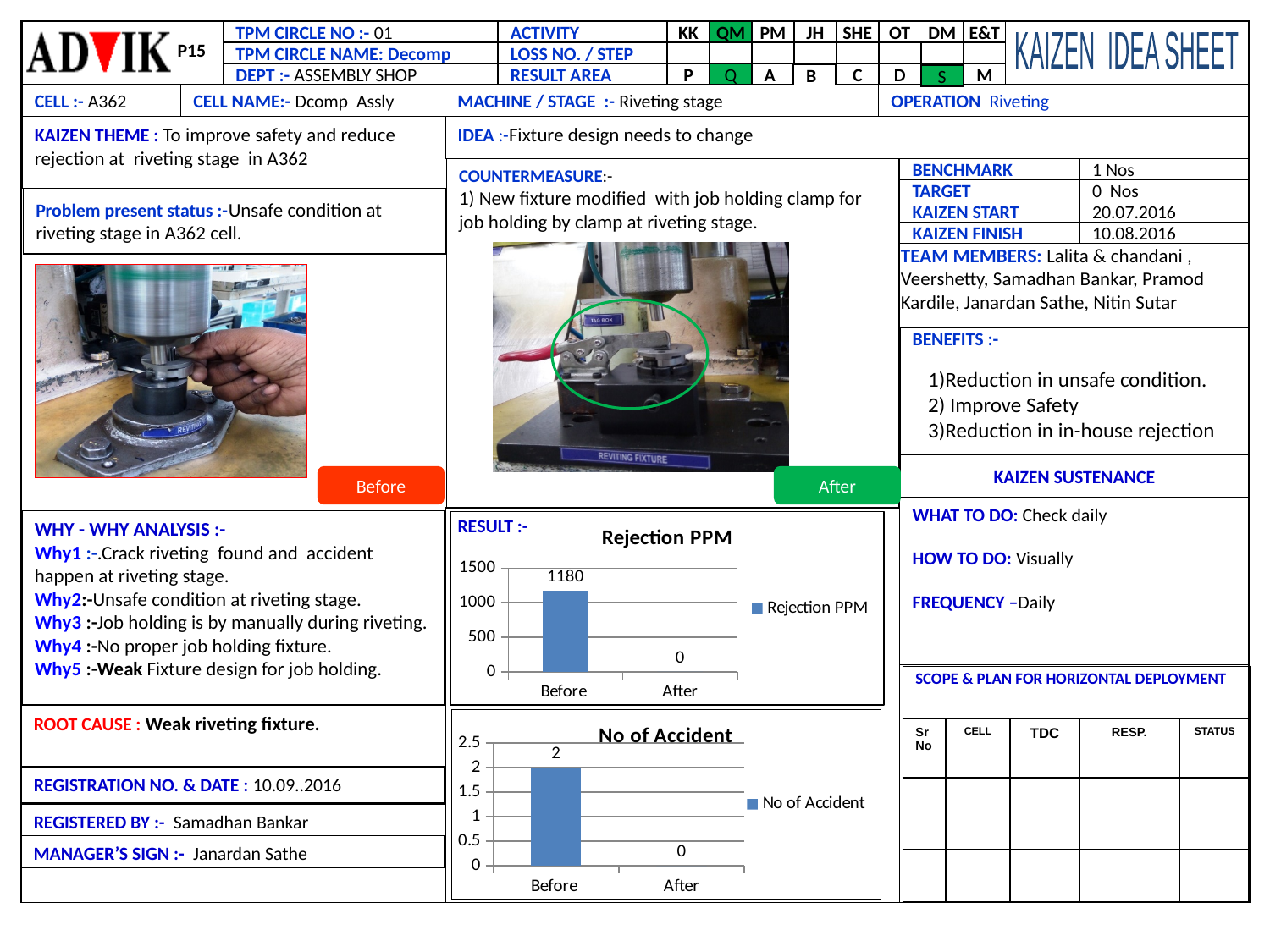
What type of chart is the Rejection PPM chart? Bar chart In the Rejection PPM chart, which category has the higher value, Before or After? Before In the No of Accident chart, how many categories are shown on the x axis? 2 In the No of Accident chart, do the values rise or fall from Before to After? Fall How many series does the legend of the Rejection PPM chart list? 1 In the No of Accident chart, what is the value for Before? 2 In the Rejection PPM chart, what is the value for Before? 1180 In the No of Accident chart, which category has the lowest value? After In the Rejection PPM chart, what is the value for After? 0 In the Rejection PPM chart, what is the difference between the Before and After values? 1180 In the No of Accident chart, what is the value for After? 0 In the Rejection PPM chart, is the value for Before greater or less than 1000? greater